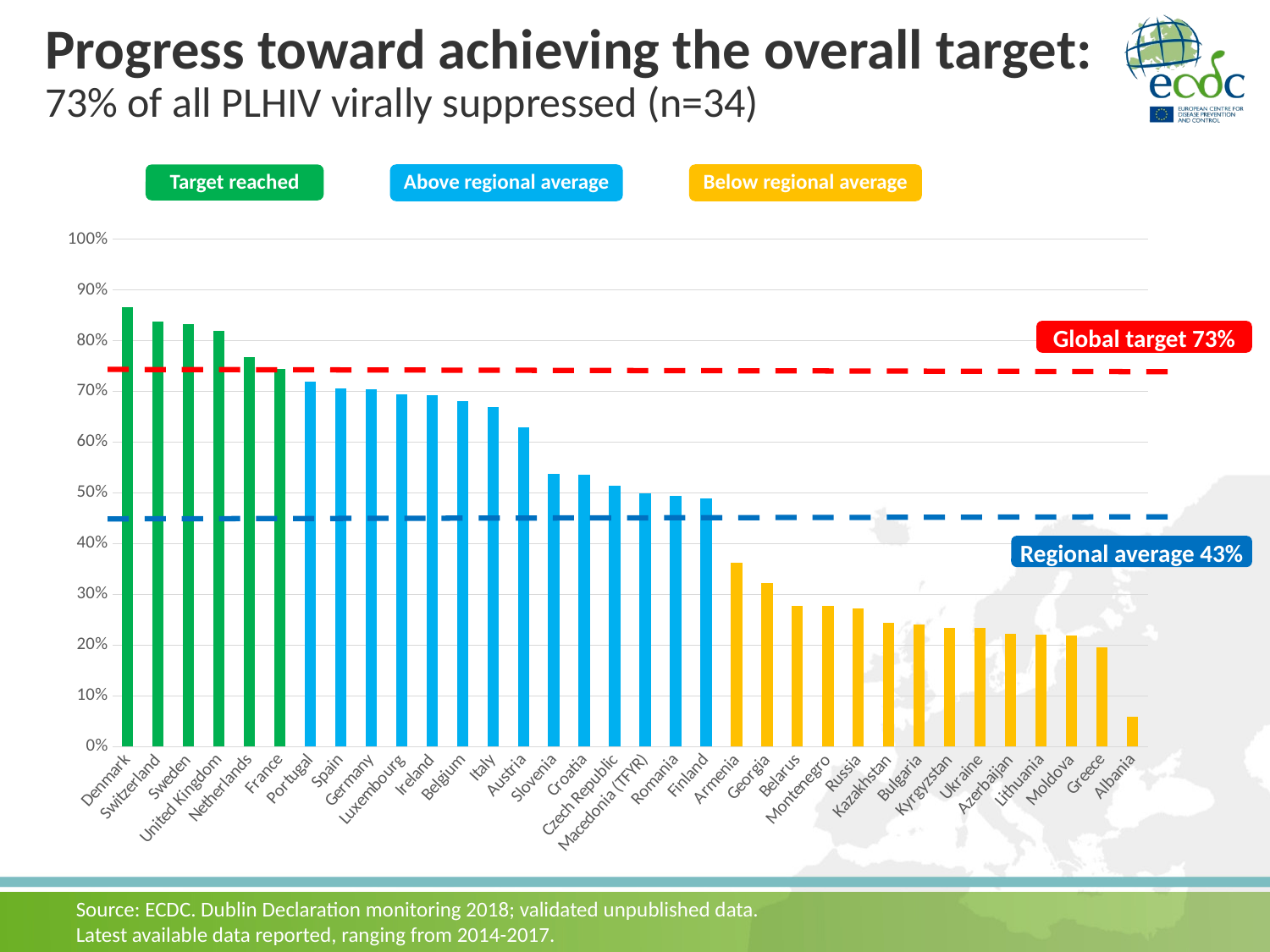
What value does the red dashed line labelled 'Global target' represent? 73% Is the value for Albania greater or less than 10%? less Which country has the highest share of PLHIV virally suppressed? Denmark Which country has the lowest share of PLHIV virally suppressed? Albania Is the value for Armenia greater or less than 40%? less Is the value for Denmark greater or less than 80%? greater How many countries are shown on the x axis of the chart? 34 How many categories does the legend above the chart list? 3 Do the bar values rise or fall moving from left to right along the x axis? fall What kind of chart is shown on the slide? bar chart Which is larger, the value for Spain or the value for Armenia? Spain